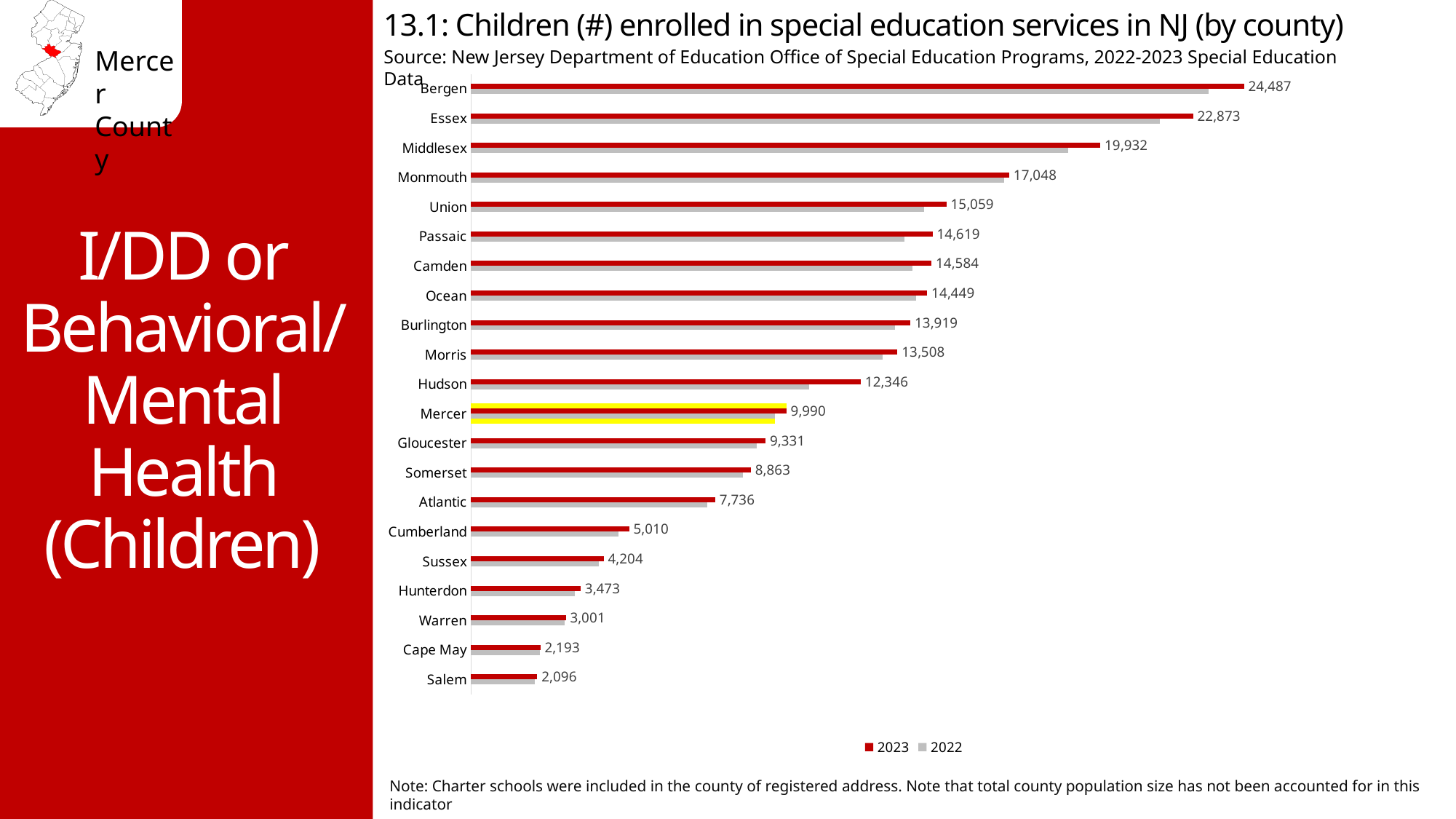
What is the 2023 value for Cumberland? 5,010 Which county has the lowest 2023 value? Salem How many series does the legend list? 2 What kind of chart is shown on the slide? bar chart Which county's bars are highlighted in yellow? Mercer Which county has the highest 2023 value? Bergen What is the 2023 value for Mercer? 9,990 How many counties are shown in the chart? 21 What is the difference between the 2023 values for Bergen and Essex? 1,614 What is the 2023 value for Bergen? 24,487 What is the difference between the 2023 values for Mercer and Gloucester? 659 For Hudson, is the 2023 value or the 2022 value larger? 2023